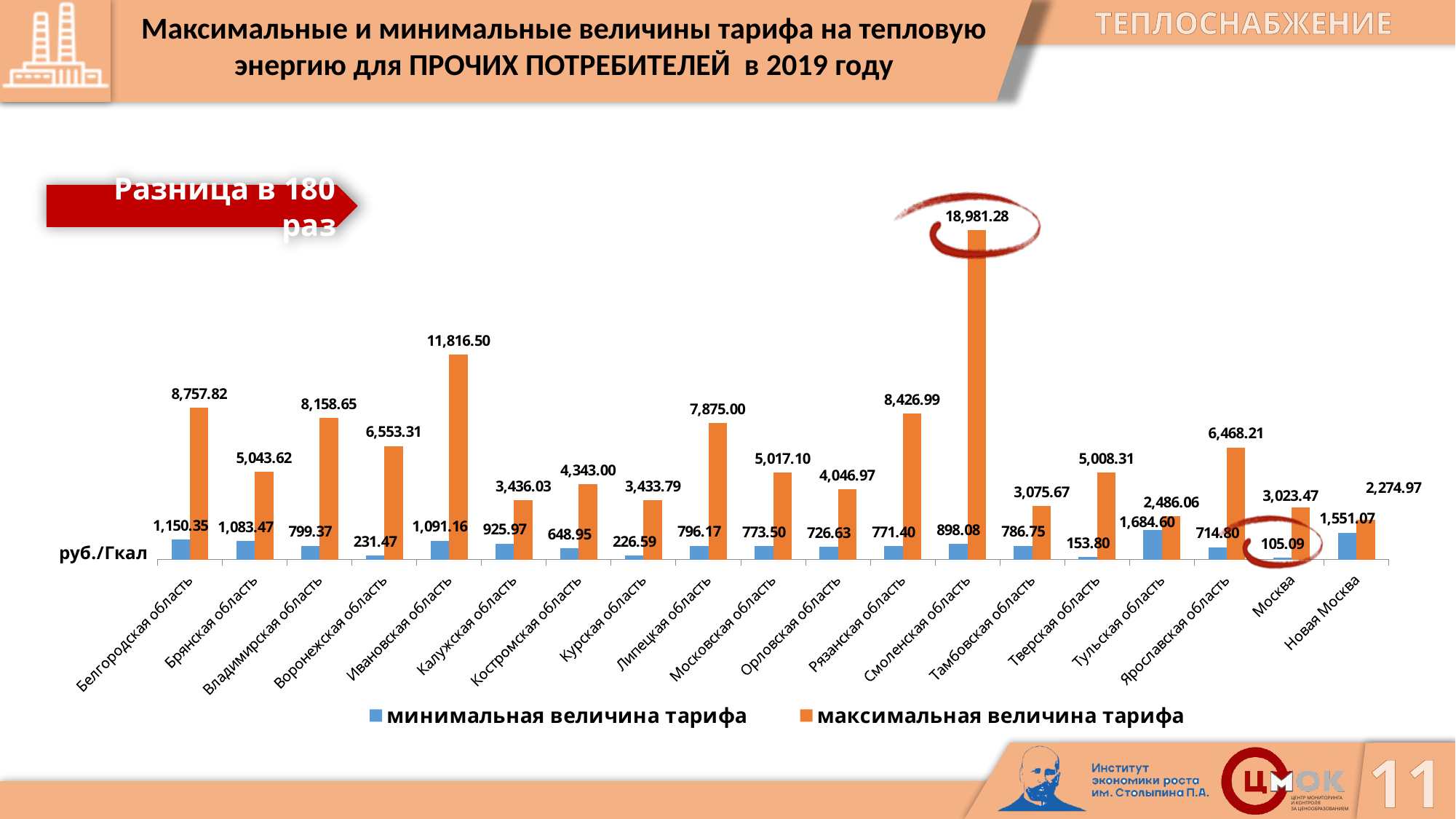
How many series does the legend list? 2 Which is larger: the maximum tariff value for Белгородская область or for Владимирская область? Белгородская область What is the maximum tariff value for Ивановская область? 11,816.50 What kind of chart is shown on the slide? Bar chart What is the difference between the maximum and minimum tariff values for Смоленская область? 18,083.20 How many regions are shown on the x axis of the chart? 19 Which region has the highest maximum tariff value? Смоленская область What is the minimum tariff value (минимальная величина тарифа) for Москва? 105.09 What is the minimum tariff value for Тульская область? 1,684.60 Which region has the lowest maximum tariff value? Новая Москва What is the maximum tariff value (максимальная величина тарифа) for Смоленская область? 18,981.28 Which region has the lowest minimum tariff value? Москва